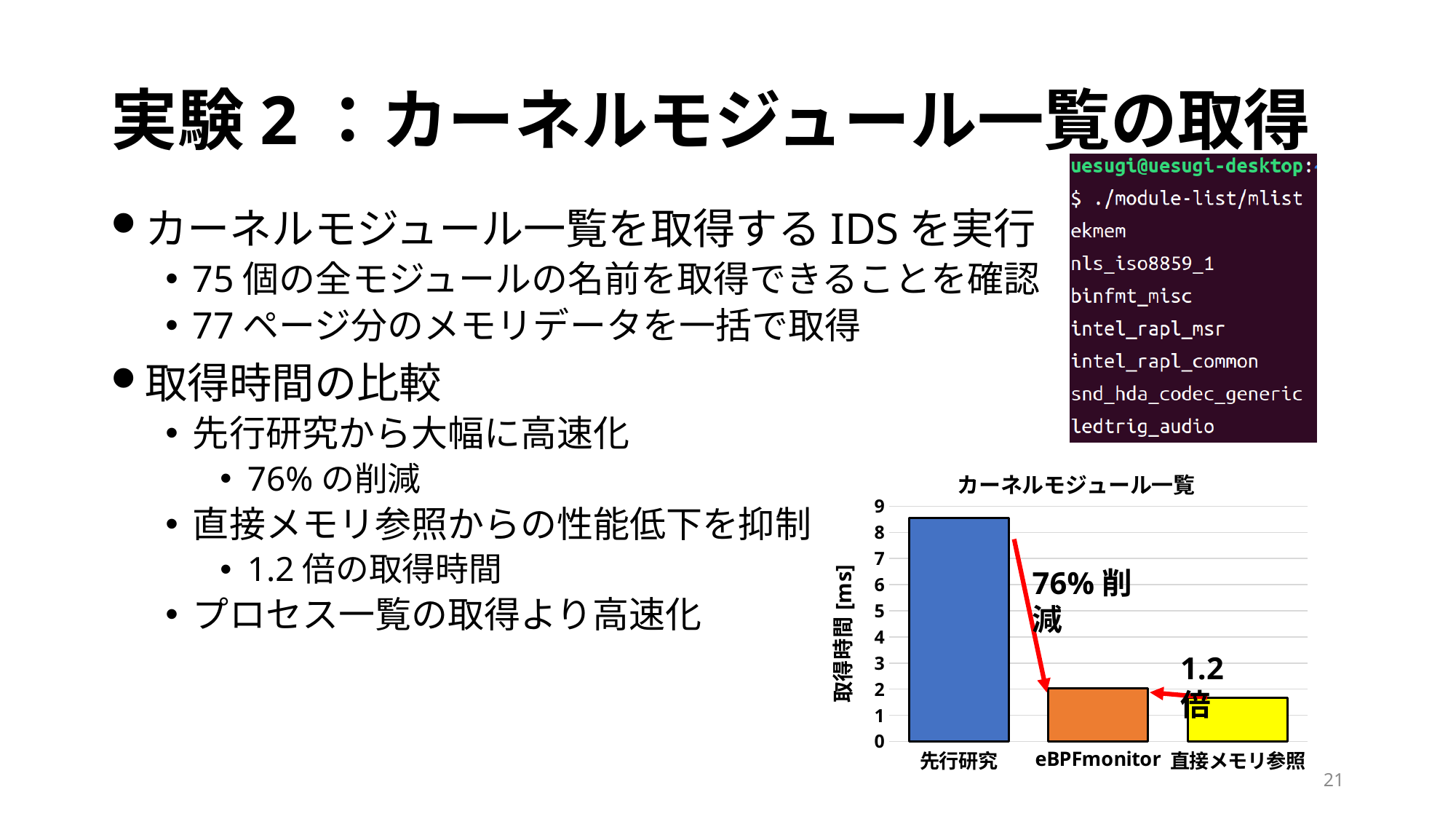
Is the value for eBPFmonitor greater or less than 3? less What is the title of the chart? カーネルモジュール一覧 What is the label of the vertical axis of the chart? 取得時間 [ms] How many bars are plotted in the chart? 3 Which category has the lowest value in the chart? 直接メモリ参照 Which category has the highest value in the chart? 先行研究 Is the value for 先行研究 greater or less than 8? greater Is the value for 直接メモリ参照 greater or less than 1? greater Do the values rise or fall from left to right across the categories? fall Which is larger, the value for 先行研究 or the value for eBPFmonitor? 先行研究 What kind of chart is shown on the slide? bar chart What is the highest tick value shown on the vertical axis? 9